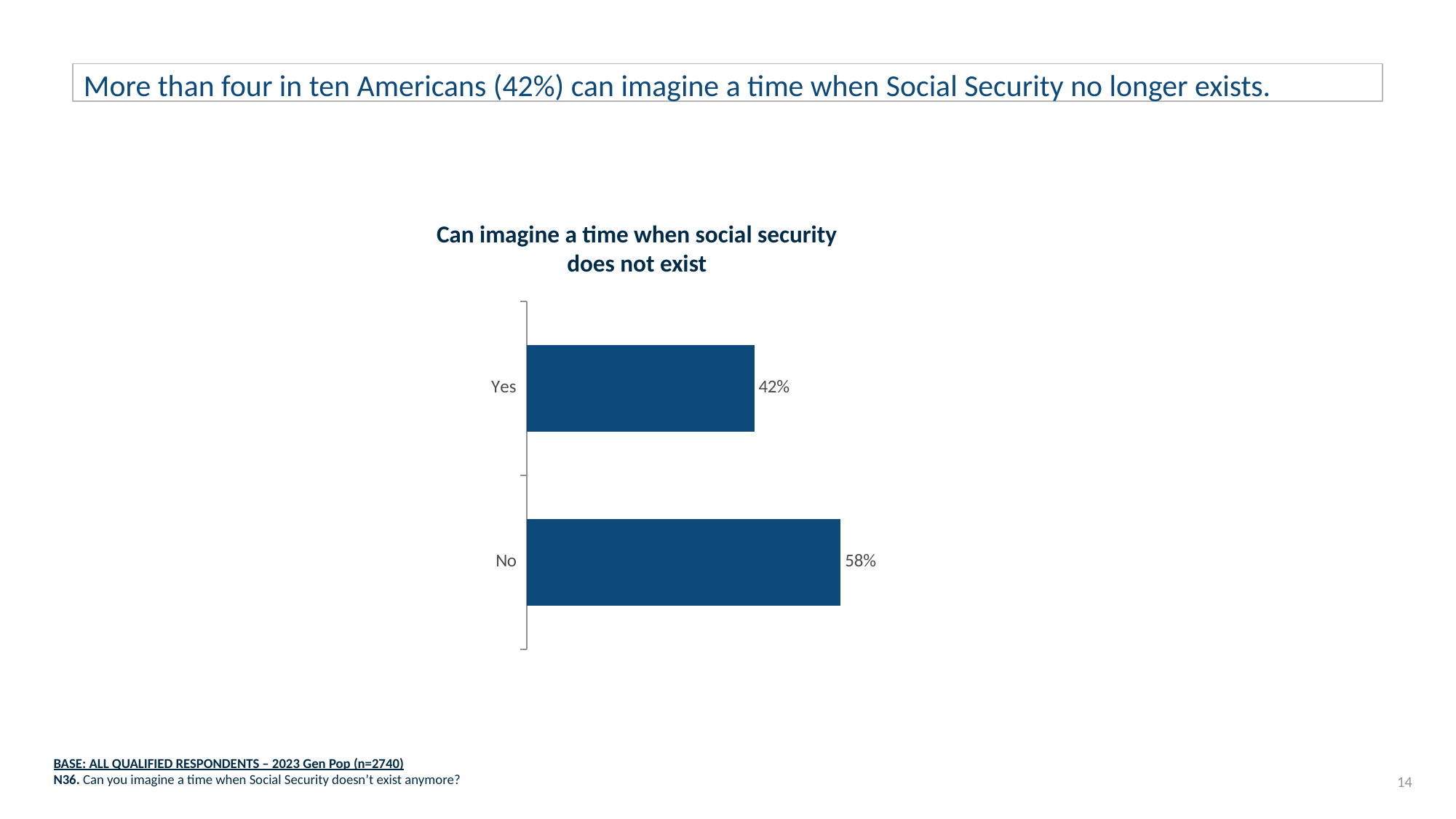
What percentage of respondents answered No? 58% What is the title of the chart? Can imagine a time when social security does not exist Which category has the higher value, Yes or No? No Which category has the lowest value? Yes Is the value for Yes larger or smaller than the value for No? smaller What is the difference between the No and Yes percentages? 16% What percentage of respondents answered Yes to being able to imagine a time when social security does not exist? 42% What is the total of the Yes and No percentages? 100% How many categories are shown in the chart? 2 What type of chart is shown on the slide? bar chart What colour are the bars in the chart? dark blue